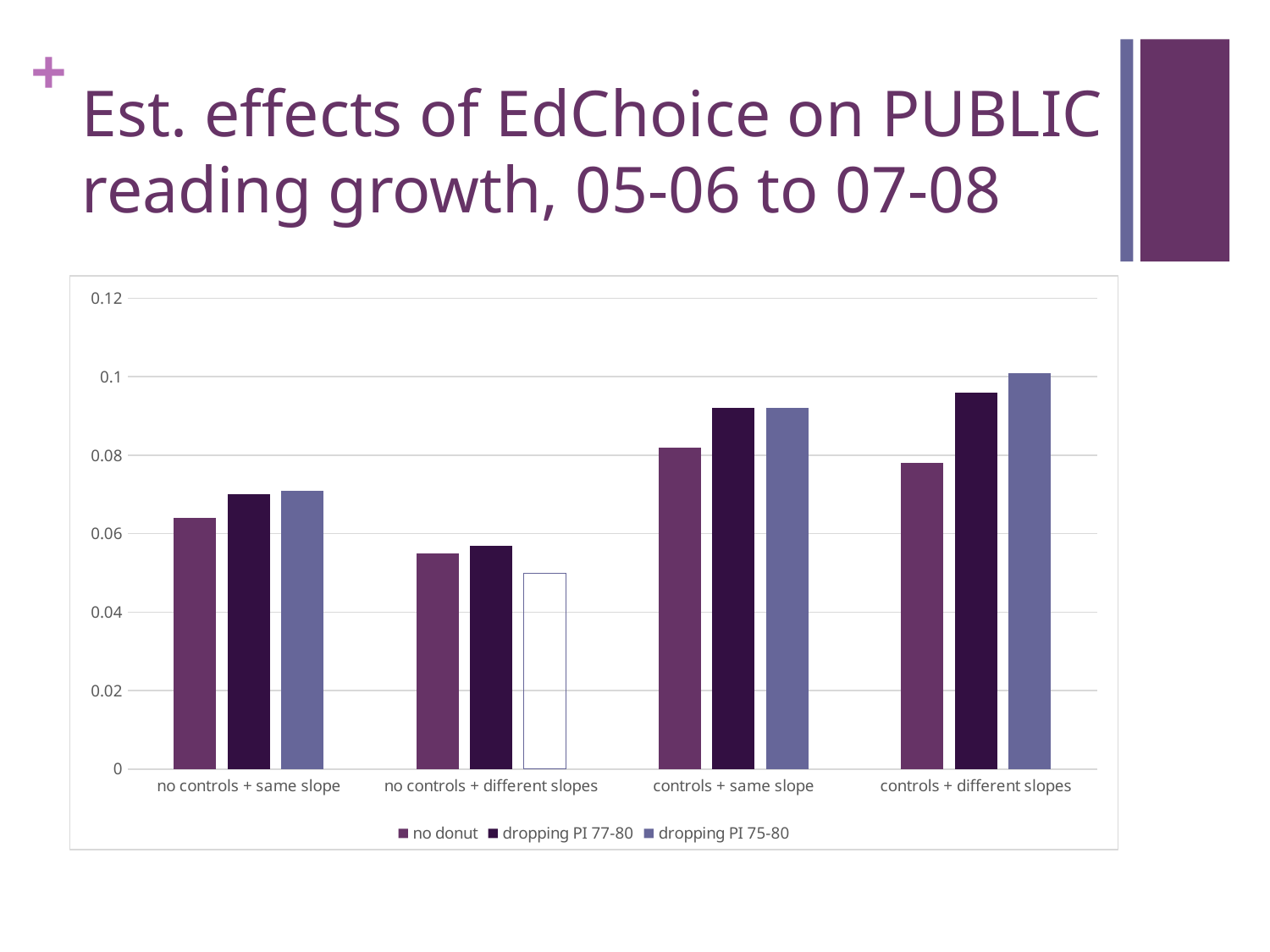
Is the 'no donut' value larger for 'controls + same slope' or for 'no controls + same slope'? controls + same slope What kind of chart is shown on the slide? bar chart What is the title of the slide containing the chart? Est. effects of EdChoice on PUBLIC reading growth, 05-06 to 07-08 Within the 'controls + different slopes' category, which series has the highest bar? dropping PI 75-80 Is the 'dropping PI 75-80' value for 'controls + different slopes' greater or less than 0.08? greater Is the 'no donut' value for 'no controls + different slopes' greater or less than 0.06? less How many series does the chart's legend list? 3 How many categories are shown on the x axis of the chart? 4 Is the 'no donut' value for 'no controls + same slope' greater or less than 0.06? greater What are the three series listed in the chart's legend? no donut, dropping PI 77-80, dropping PI 75-80 For the 'no donut' series, which category has the lowest value? no controls + different slopes